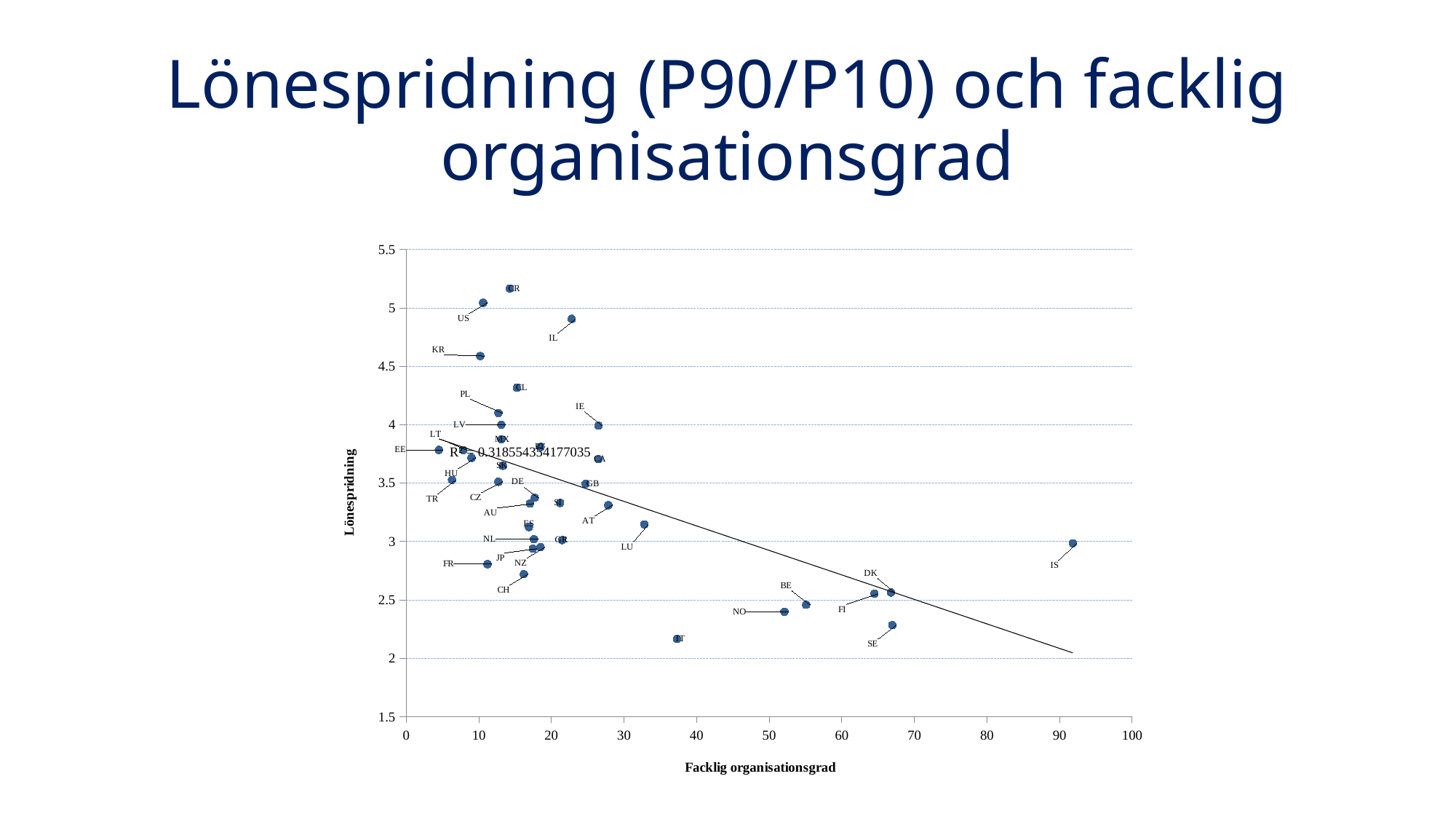
Do the values of Lönespridning generally rise or fall as Facklig organisationsgrad increases? fall What kind of chart is shown on the slide? scatter chart Is the Lönespridning for LU greater or less than 3? greater Is the Lönespridning for SE greater or less than 2.5? less Which has the higher Lönespridning, KR or IL? IL Which country has the highest Facklig organisationsgrad? IS What is the title of the y axis? Lönespridning Is the Facklig organisationsgrad for IS greater or less than 80? greater Which has the higher Lönespridning, DK or SE? DK What is the title of the x axis? Facklig organisationsgrad